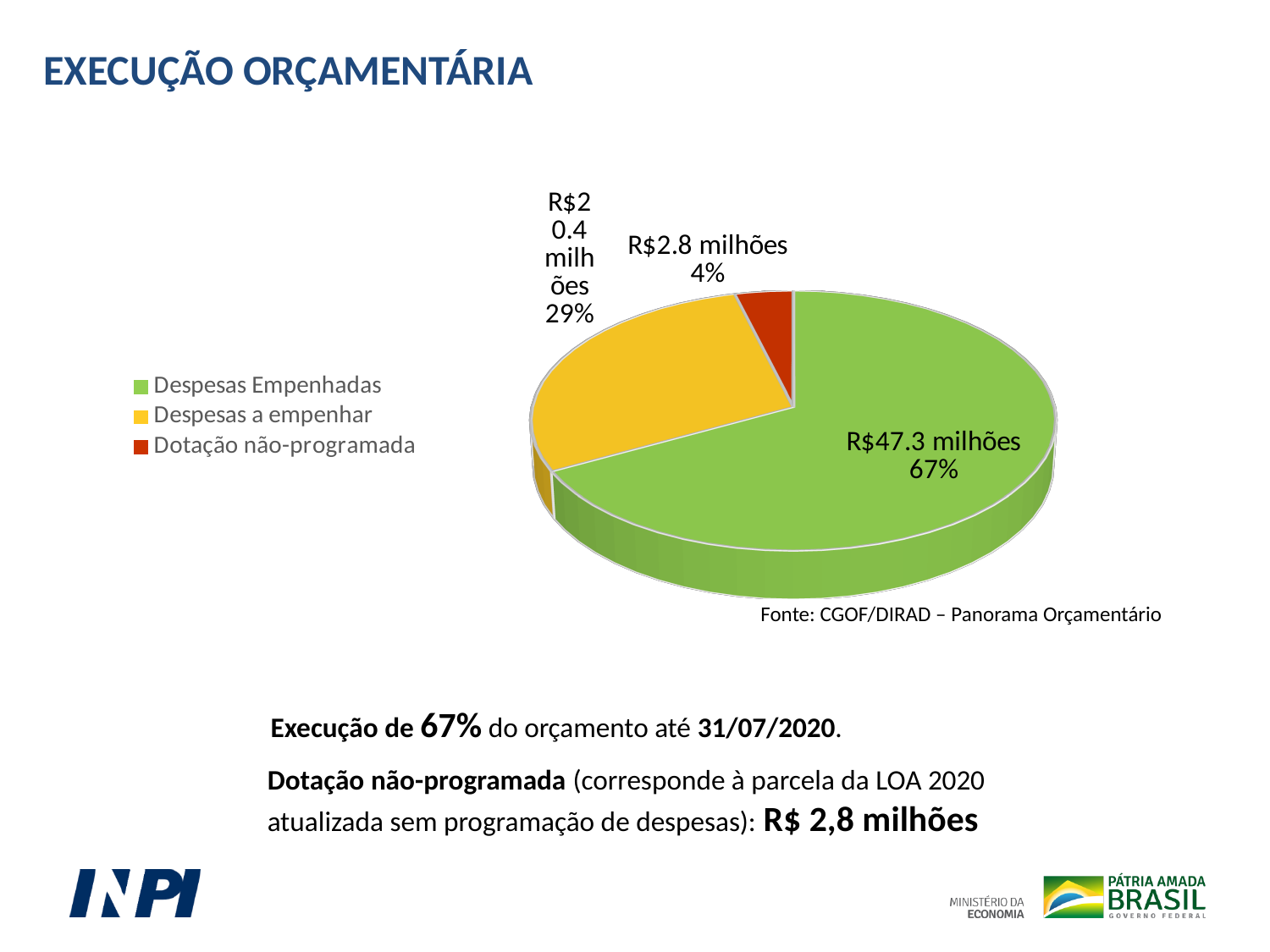
Which category has the largest slice of the pie? Despesas Empenhadas What is the value shown for Despesas a empenhar? R$20.4 milhões How many categories does the pie chart have? 3 What percentage of the pie does Despesas a empenhar represent? 29% What is the value shown for Dotação não-programada? R$2.8 milhões What is the value shown for Despesas Empenhadas? R$47.3 milhões What colour is the slice for Despesas a empenhar? Yellow What kind of chart is shown on the slide? Pie chart Which category has the smallest slice of the pie? Dotação não-programada What percentage of the pie does Dotação não-programada represent? 4% Which is larger, Despesas a empenhar or Dotação não-programada? Despesas a empenhar What percentage of the pie does Despesas Empenhadas represent? 67%